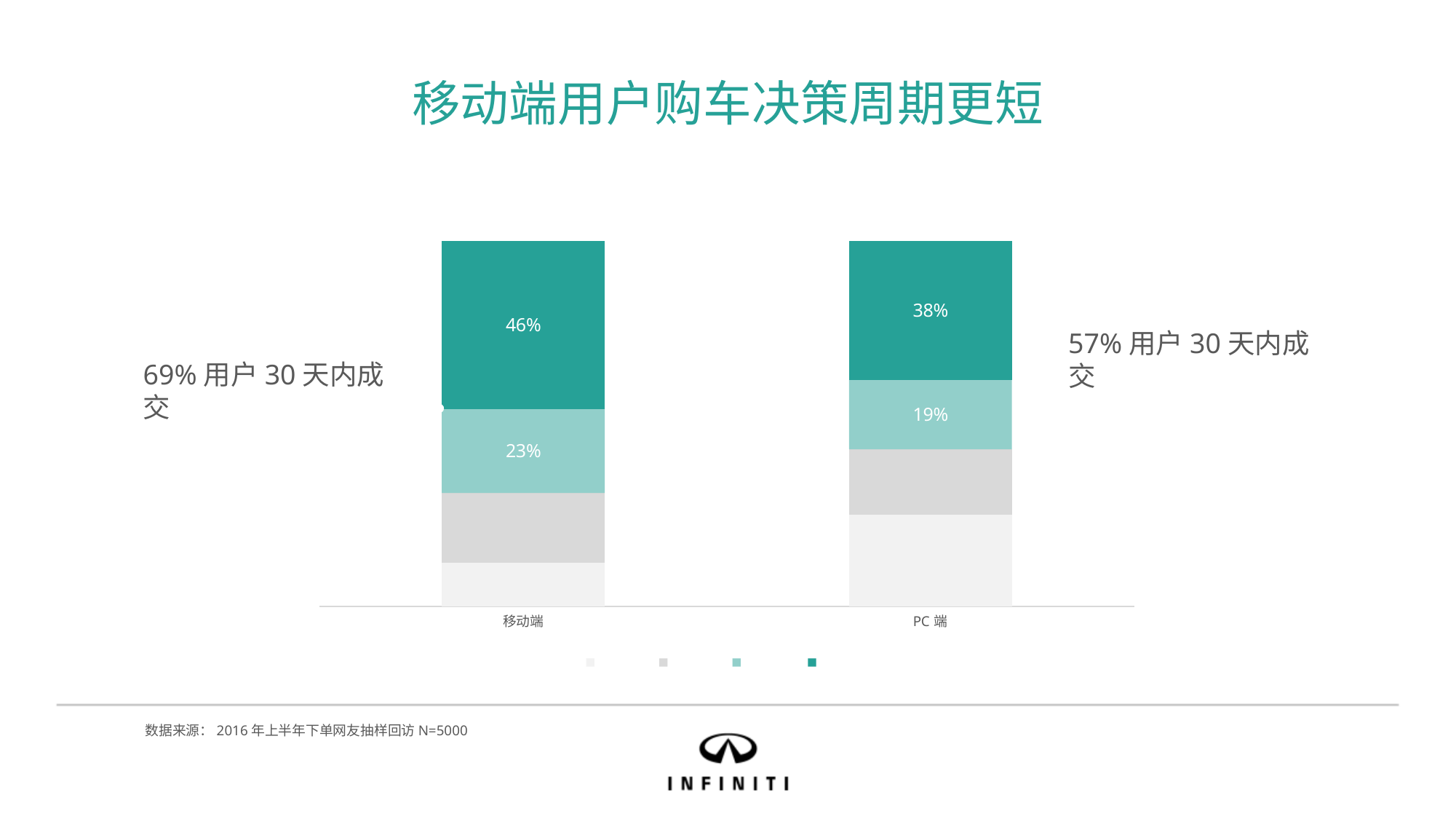
What is the combined value of the two teal segments in the 移动端 bar? 69% Which category has the larger dark teal segment, 移动端 or PC 端? 移动端 What value is shown on the light teal segment of the 移动端 bar? 23% What is the difference between the dark teal segment values of 移动端 and PC 端? 8% What is the difference between the light teal segment values of 移动端 and PC 端? 4% What kind of chart is shown on the slide? Stacked bar chart Which category has the smaller light teal segment? PC 端 What value is shown on the dark teal segment of the PC 端 bar? 38% How many categories are shown on the x axis? 2 What is the combined value of the two teal segments in the PC 端 bar? 57% What value is shown on the dark teal segment of the 移动端 bar? 46% What value is shown on the light teal segment of the PC 端 bar? 19%